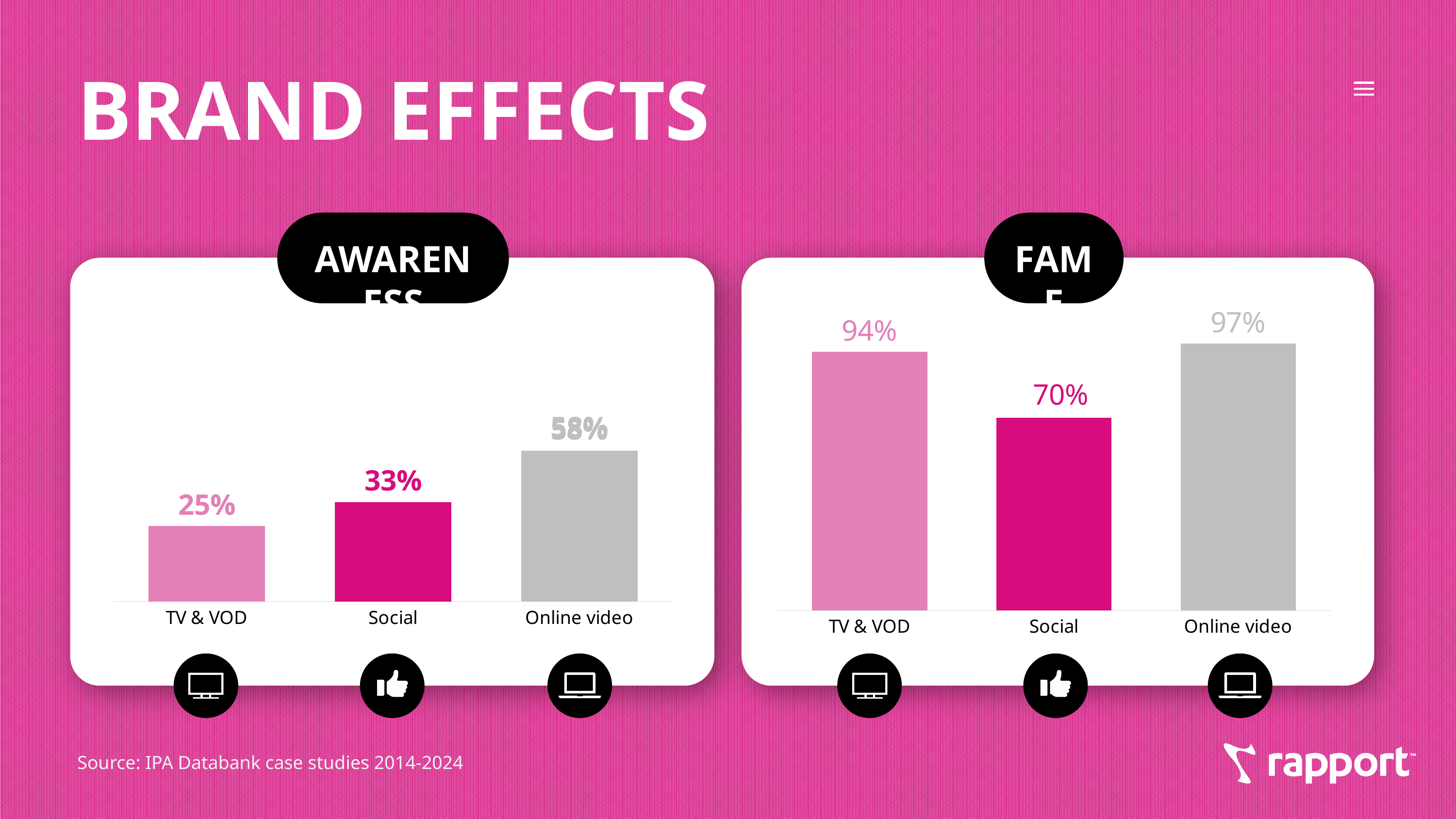
On the left chart, what is the value for Online video? 58% What type of chart is the left chart? Bar chart On the left chart, what is the difference between the values for Online video and TV & VOD? 33% On the right chart, what is the value for Online video? 97% On the right chart, what is the value for Social? 70% How many categories are shown on the right chart? 3 On the right chart, which category has the lowest value? Social On the right chart, what is the value for TV & VOD? 94% On the right chart, what is the difference between the values for TV & VOD and Social? 24% On the left chart, what is the value for TV & VOD? 25% On the left chart, what is the value for Social? 33% On the left chart, which category has the highest value? Online video